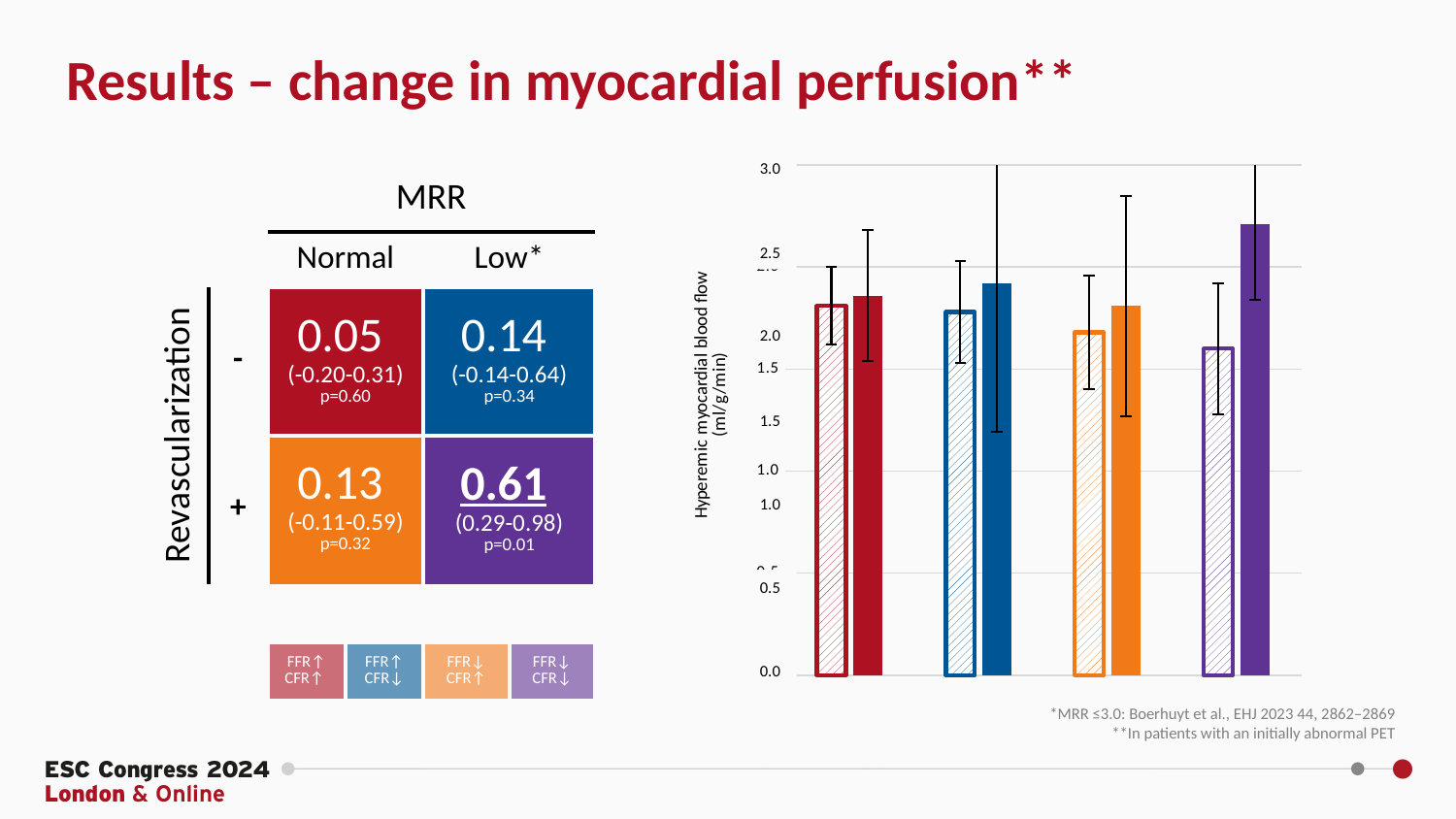
Which bar in the bar chart is the tallest? the solid purple bar In the bar chart, is the value of the hatched purple bar greater or less than 2.0? less What kind of chart is shown on the right side of the slide? bar chart Which bar in the bar chart is the shortest? the hatched purple bar What is the highest value shown on the y-axis of the bar chart? 3.0 How many pairs of bars (hatched and solid) does the bar chart show? 4 How many bars are plotted in the bar chart on the right? 8 In the bar chart, which is larger: the solid purple bar or the solid red bar? the solid purple bar In the bar chart, which is larger: the solid purple bar or the hatched purple bar? the solid purple bar What is the y-axis label of the bar chart? Hyperemic myocardial blood flow (ml/g/min)